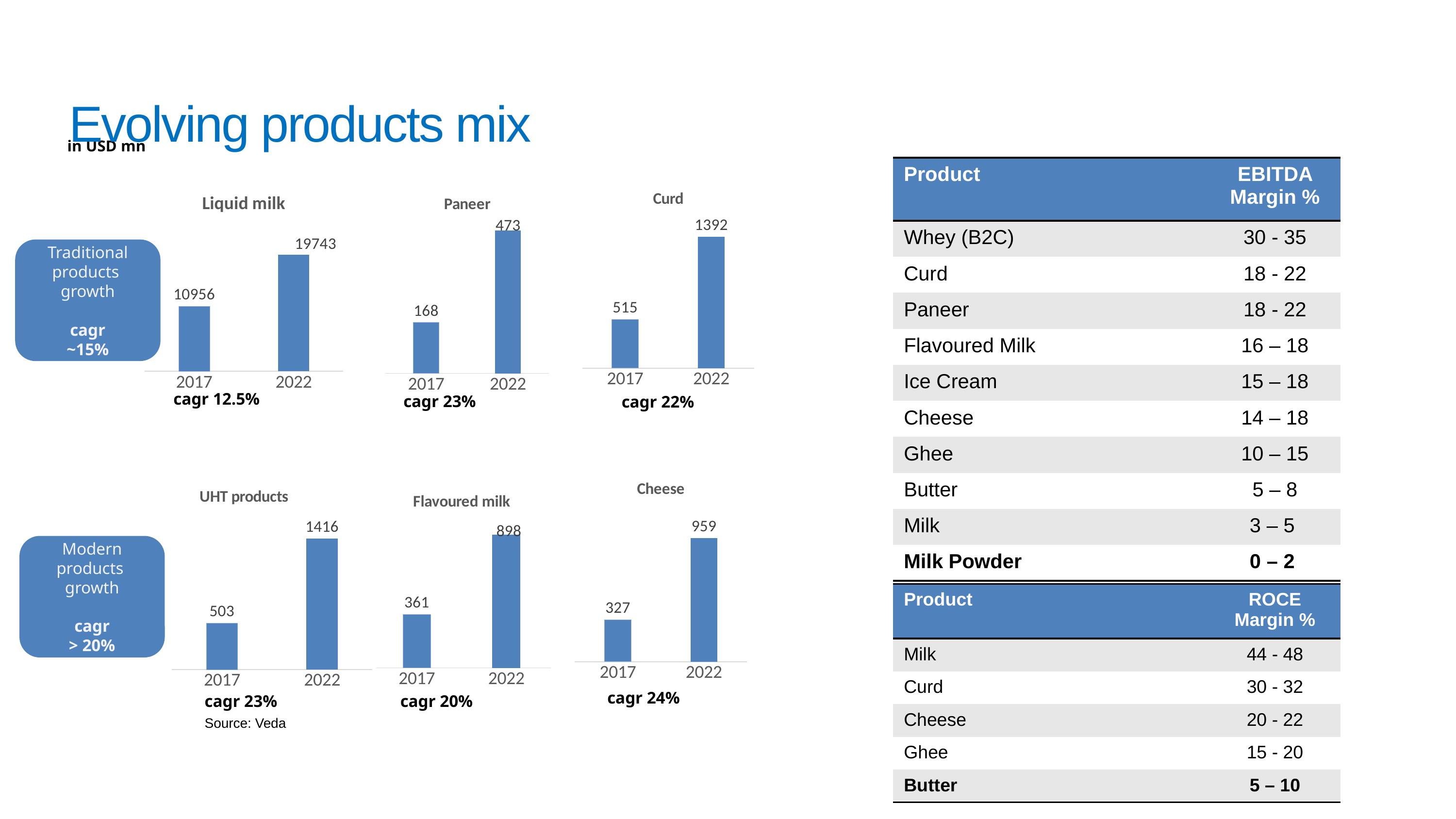
In the Curd chart, do the values rise or fall from 2017 to 2022? rise In the UHT products chart, what is the difference between the 2022 and 2017 values? 913 In the Cheese chart, which year has the higher value, 2017 or 2022? 2022 In the UHT products chart, what is the value for 2017? 503 In the Flavoured milk chart, what is the value for 2022? 898 In the Paneer chart, what is the value for 2017? 168 In the Curd chart, what is the value for 2022? 1392 In the Cheese chart, what is the value for 2017? 327 What kind of chart is the Flavoured milk chart? bar chart In the Liquid milk chart, what is the difference between the 2022 and 2017 values? 8787 In the Liquid milk chart, what is the value for 2022? 19743 How many bars are shown in the Paneer chart? 2